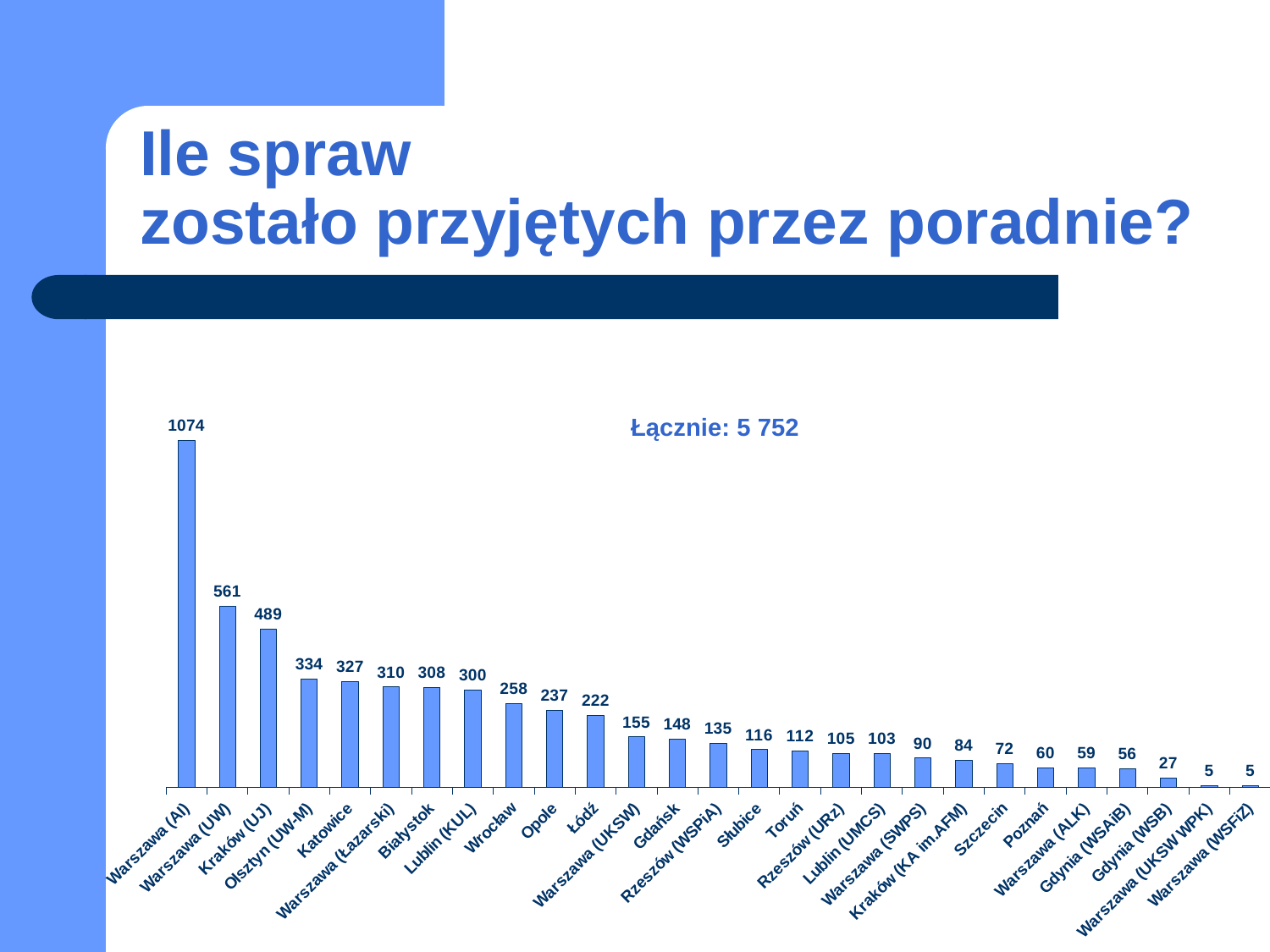
How many categories are shown on the chart? 27 Which is larger, the value for Katowice or the value for Olsztyn (UW-M)? Olsztyn (UW-M) How many cases does the bar for Warszawa (AI) show? 1074 What kind of chart is shown on the slide? Bar chart What is the difference between the values for Warszawa (UW) and Kraków (UJ)? 72 Which category has the highest value? Warszawa (AI) What value is shown for Kraków (UJ)? 489 What value is shown for Szczecin? 72 What value is shown for Gdańsk? 148 What is the lowest value shown on the chart? 5 What total is stated on the chart next to 'Łącznie'? 5 752 Do the values rise or fall from left to right along the x axis? Fall